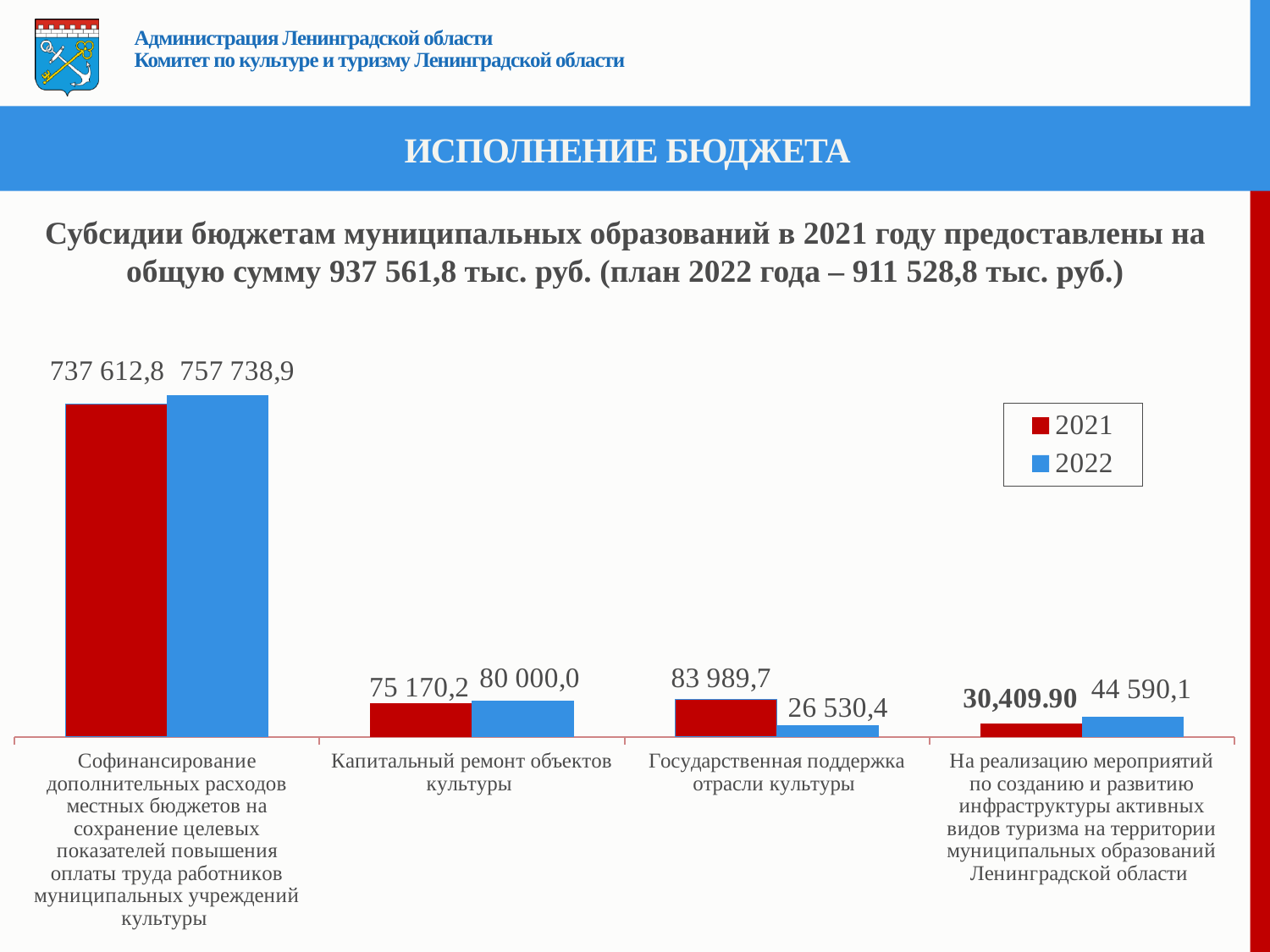
How many categories are shown on the x axis? 4 What is the difference between the 2022 and 2021 values for Софинансирование дополнительных расходов местных бюджетов? 20 126,1 Which category has the lowest 2022 value? Государственная поддержка отрасли культуры What is the 2022 value for Государственная поддержка отрасли культуры? 26 530,4 What kind of chart is shown on the slide? Bar chart What is the 2022 value for Софинансирование дополнительных расходов местных бюджетов? 757 738,9 What is the 2021 value for Капитальный ремонт объектов культуры? 75 170,2 What is the 2021 value for На реализацию мероприятий по созданию и развитию инфраструктуры активных видов туризма? 30,409.90 Which category has the highest 2021 value? Софинансирование дополнительных расходов местных бюджетов What is the difference between the 2021 and 2022 values for Государственная поддержка отрасли культуры? 57 459,3 For Капитальный ремонт объектов культуры, which year has the larger value, 2021 or 2022? 2022 How many series does the legend list? 2